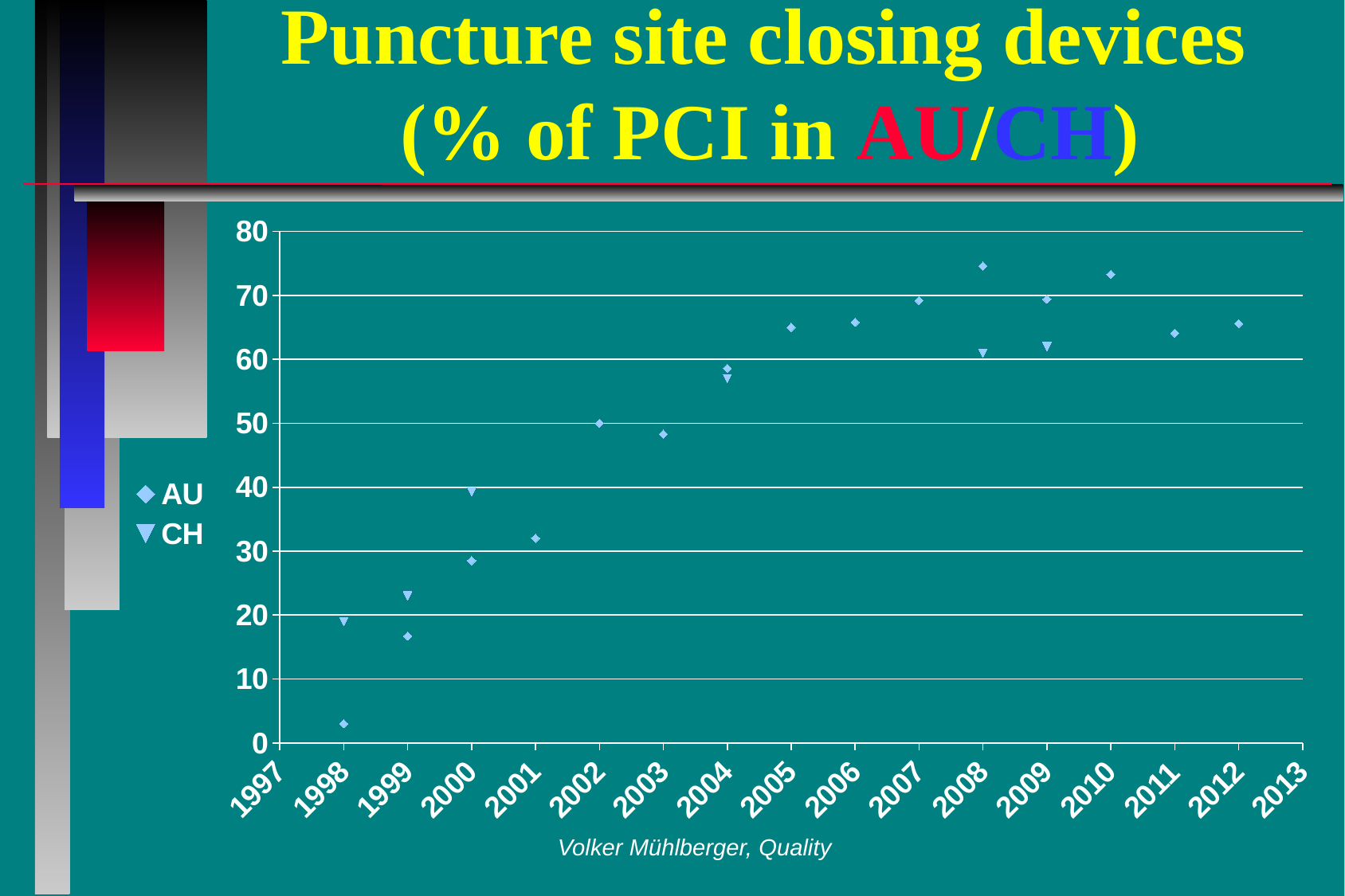
How many series does the legend list? 2 What are the two series named in the legend? AU and CH In 1998, which series has the larger value, AU or CH? CH Is the AU value for 2008 greater or less than 70? greater Is the CH value for 2004 greater or less than 60? less In 2008, which series has the larger value, AU or CH? AU What kind of chart is shown on the slide? scatter chart Is the AU value for 1998 greater or less than 10? less How many data points are plotted for the CH series? 6 In which year is the AU value lowest? 1998